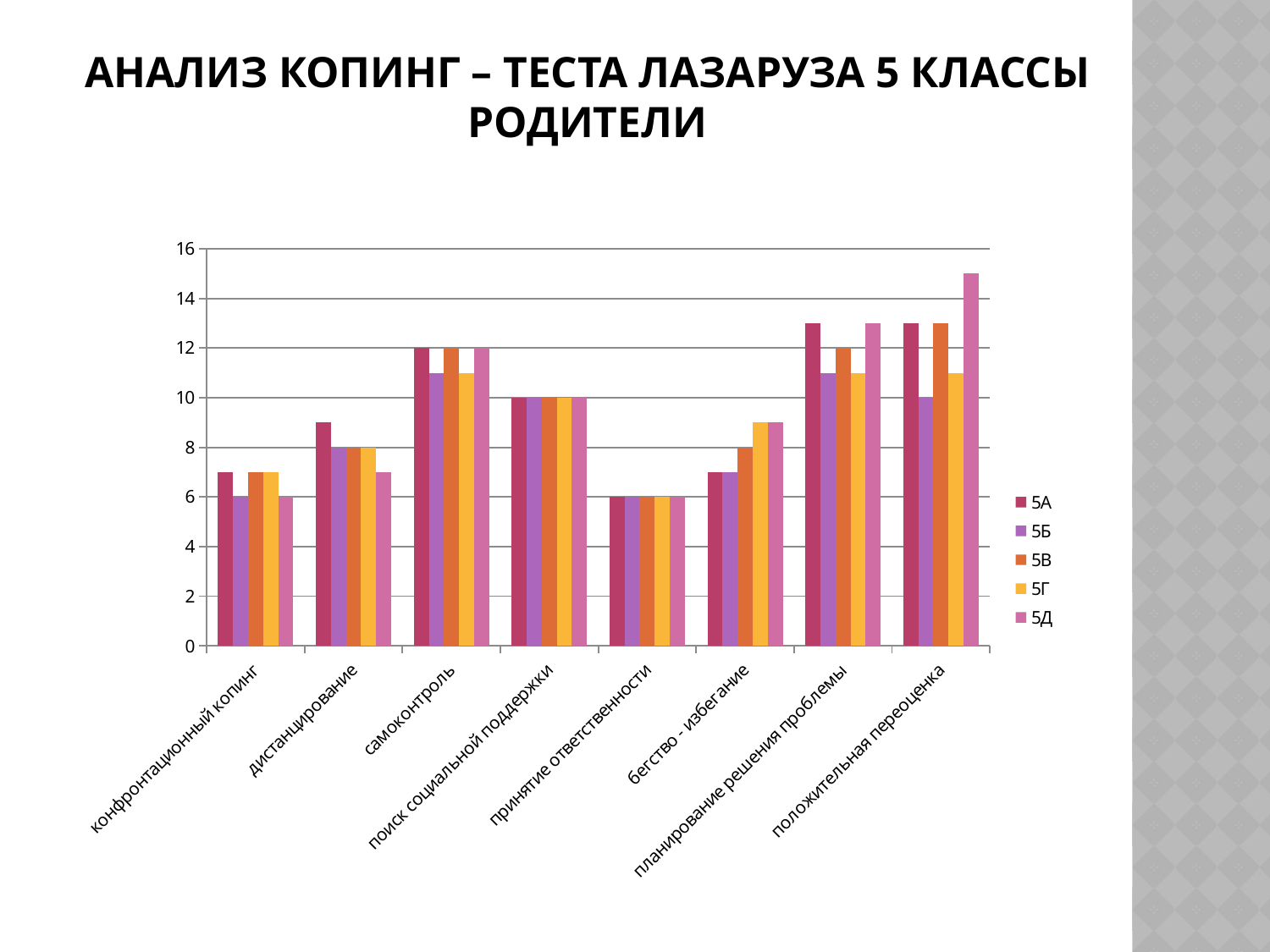
For the series 5А, which category has the lowest value? принятие ответственности How many categories are shown along the x axis? 8 Is the value for 5А in планирование решения проблемы greater or less than 12? greater What kind of chart is shown on the slide? bar chart What is the value for 5Д in the category принятие ответственности? 6 What is the difference between the value for 5А in самоконтроль and the value for 5Б in положительная переоценка? 2 How many series does the legend list? 5 In the category дистанцирование, which is larger: the value for 5А or the value for 5Д? 5А What is the value for 5Б in the category поиск социальной поддержки? 10 What is the value for 5А in the category самоконтроль? 12 Which series has the highest value in the category положительная переоценка? 5Д Is the value for 5Д in положительная переоценка greater or less than 14? greater